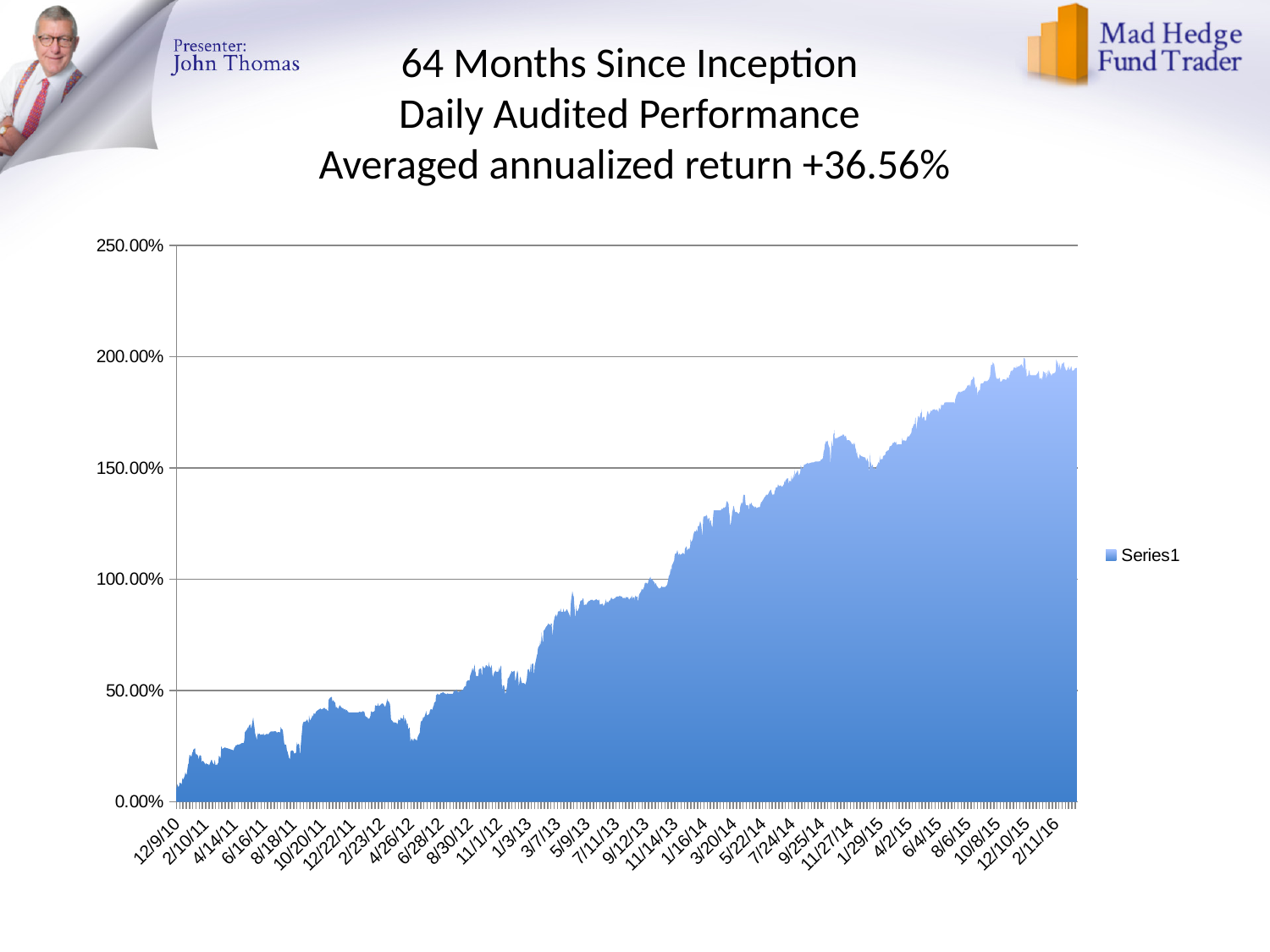
What is the highest value shown on the vertical axis? 250.00% Which is larger, the value at 12/9/10 or the value at 2/11/16? 2/11/16 Is the value at 12/9/10 greater or less than 50.00%? less Is the value at 8/6/15 greater or less than 150.00%? greater What kind of chart is shown on the slide? area chart Is the value at 2/11/16 greater or less than 150.00%? greater How many series does the legend list? 1 What is the name of the series shown in the legend? Series1 Do the values generally rise or fall from 12/9/10 to 2/11/16? rise